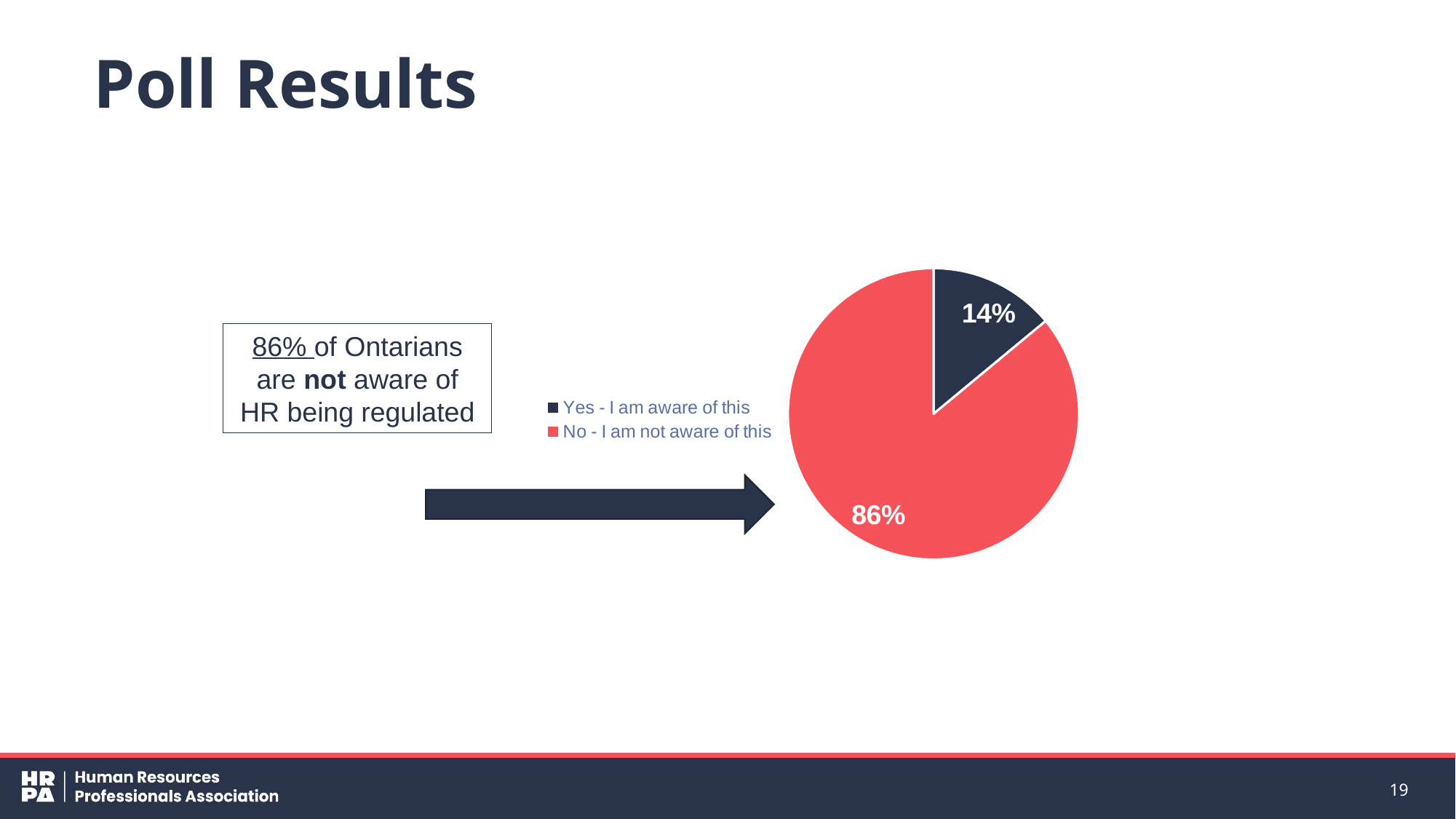
What colour is the "No - I am not aware of this" slice? red What share of the pie is labelled "Yes - I am aware of this"? 14% What kind of chart is shown on the slide? pie chart What is the difference in percentage points between the "No - I am not aware of this" slice and the "Yes - I am aware of this" slice? 72 Which slice of the pie is the largest? No - I am not aware of this Which is larger: the "Yes - I am aware of this" slice or the "No - I am not aware of this" slice? No - I am not aware of this What share of the pie is labelled "No - I am not aware of this"? 86% Which slice of the pie is the smallest? Yes - I am aware of this What colour is the "Yes - I am aware of this" slice? dark navy How many slices does the pie chart have? 2 How many entries does the legend list? 2